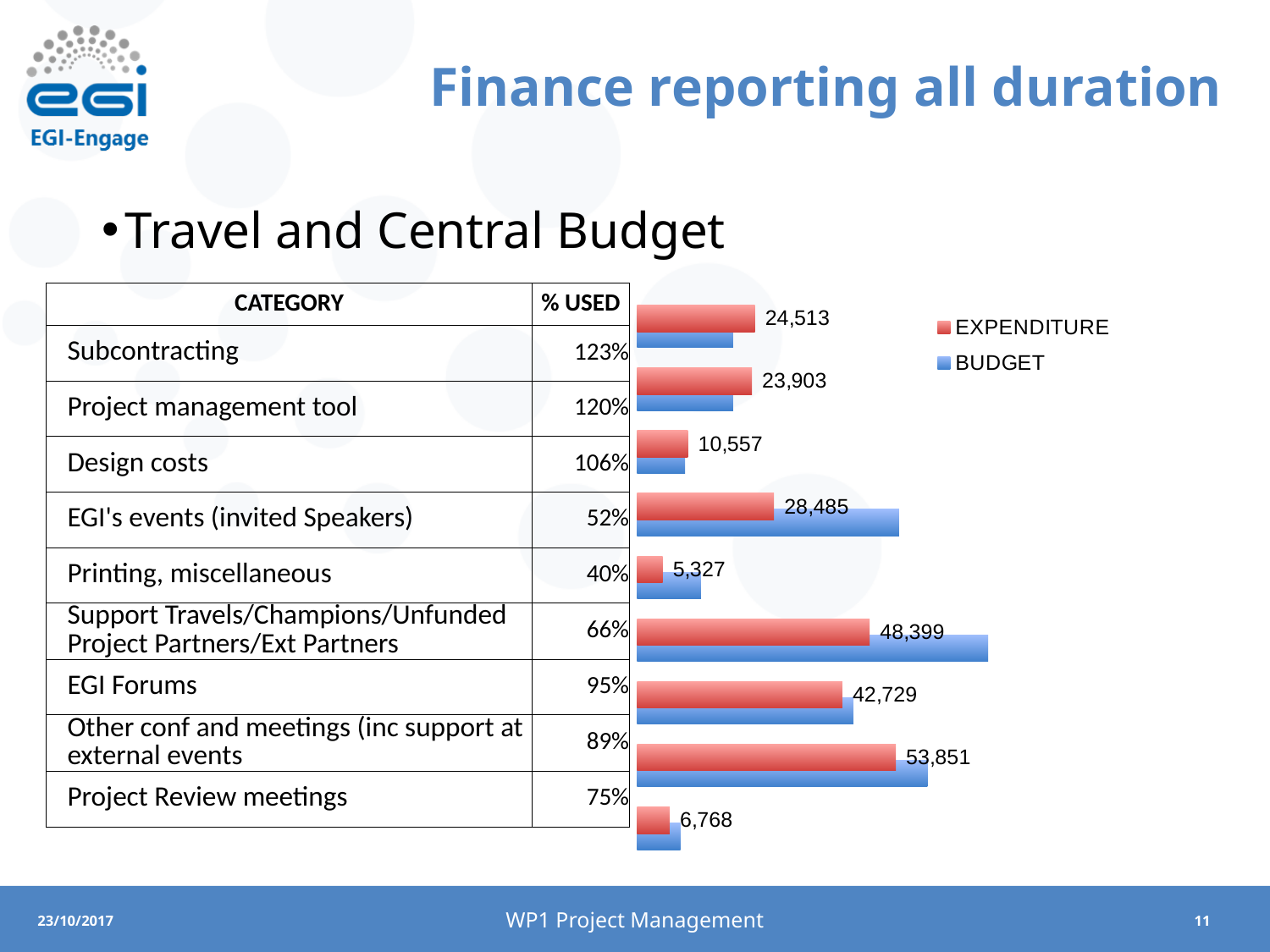
What is the lowest expenditure value labelled in the chart? 5,327 What is the highest expenditure value labelled in the chart? 53,851 How many pairs of bars (categories) are plotted in the chart? 9 What kind of chart is shown on the slide? bar chart Which is larger: the expenditure on the top bar (24,513) or on the second bar (23,903)? 24,513 What is the difference between the two largest labelled expenditure values, 53,851 and 48,399? 5,452 What is the expenditure value labelled on the third bar from the top? 10,557 What is the expenditure value labelled on the bottom bar of the chart? 6,768 What is the expenditure value labelled on the topmost bar of the chart? 24,513 How many series does the chart legend list? 2 What are the two series named in the chart legend? EXPENDITURE and BUDGET Which colour represents BUDGET in the chart? blue